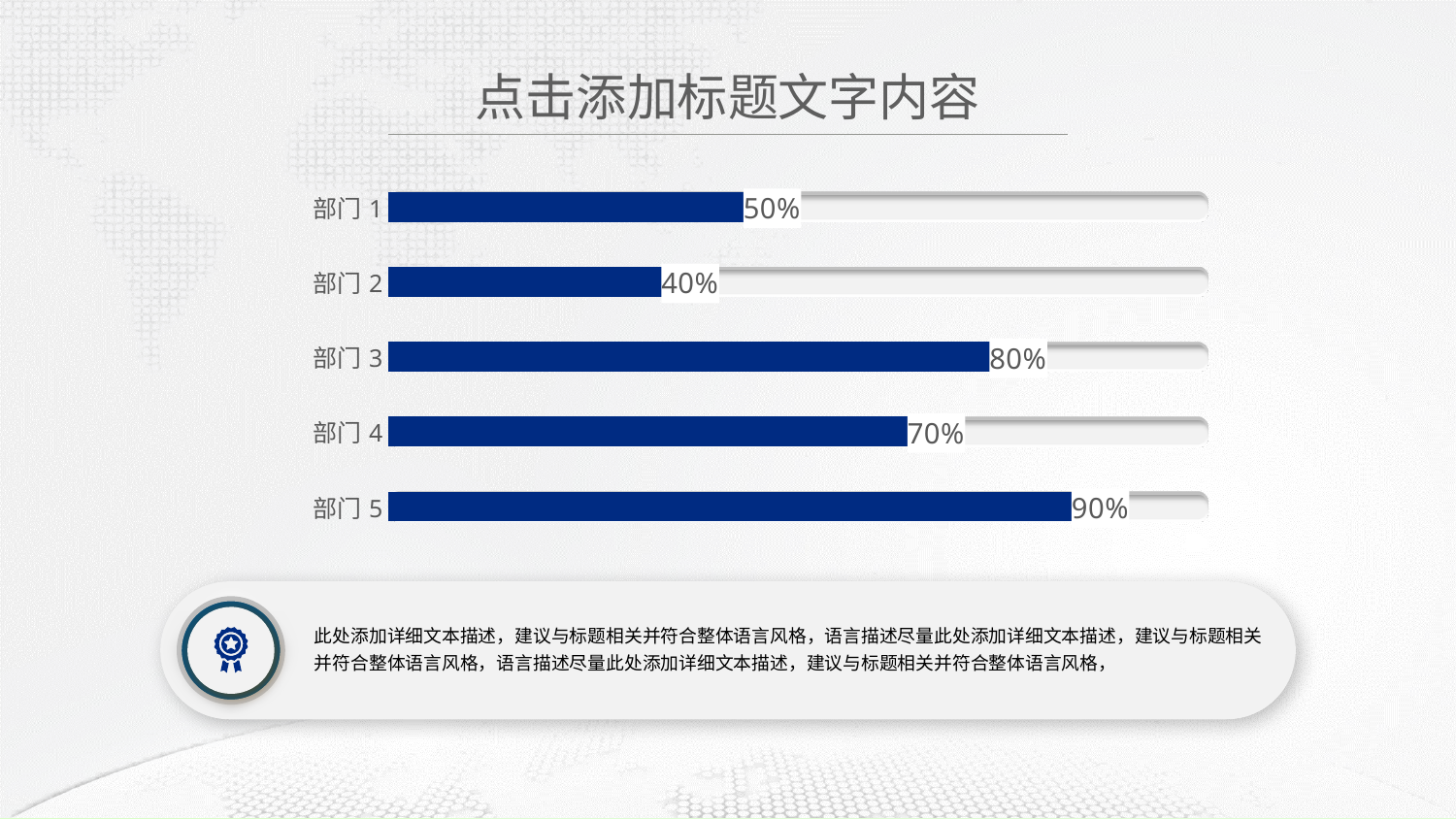
How many categories are shown in the chart? 5 What is the difference between the values for 部门 3 and 部门 4? 10% What is the value for 部门 1? 50% Are the bars in the chart horizontal or vertical? horizontal What is the difference between the values for 部门 5 and 部门 2? 50% What kind of chart is shown on the slide? bar chart Which category has the highest value? 部门 5 Which is larger, the value for 部门 1 or the value for 部门 4? 部门 4 What colour are the bars in the chart? dark blue What is the value for 部门 5? 90% What is the value for 部门 3? 80% Which category has the lowest value? 部门 2